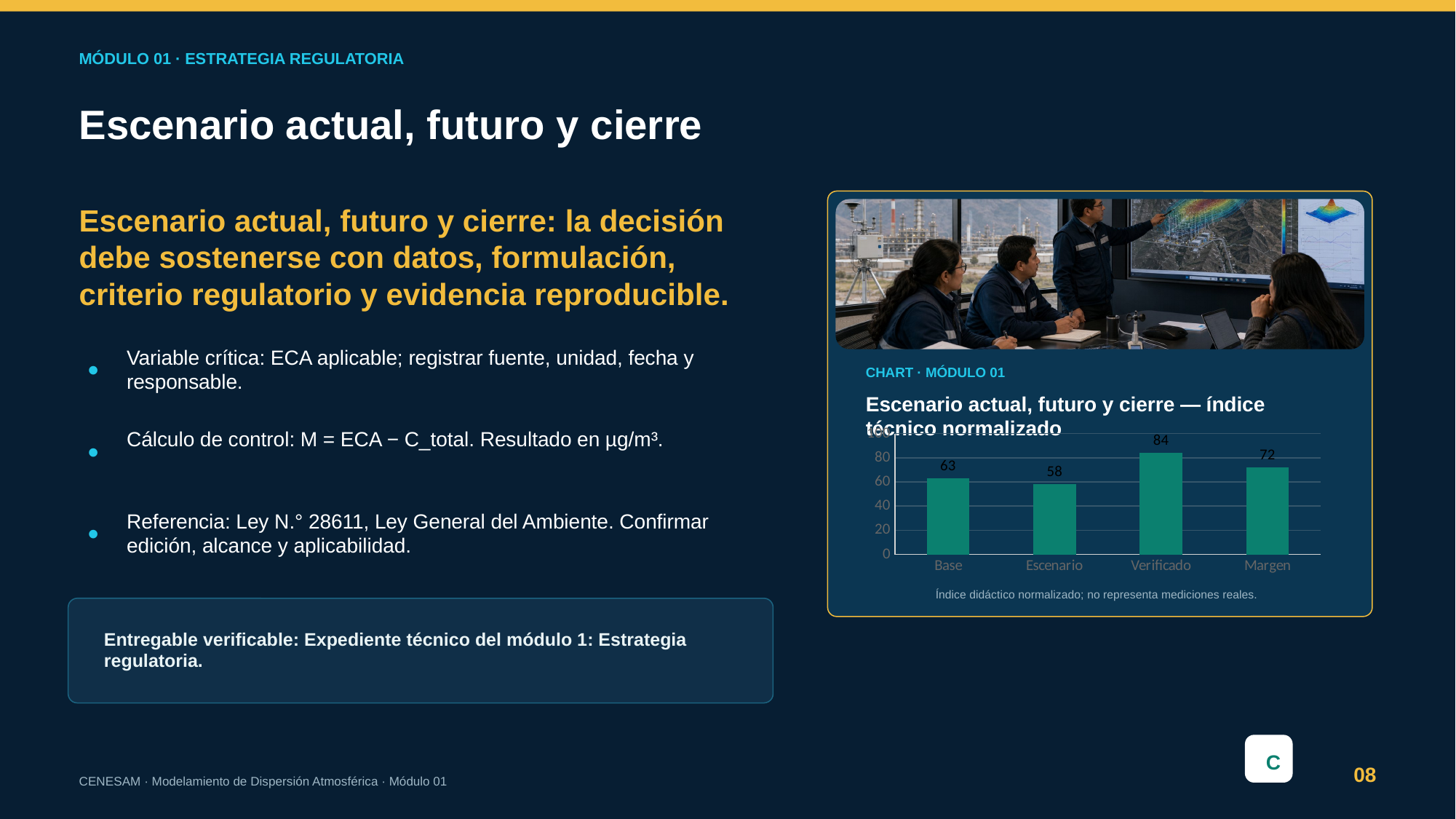
Which category has the highest value? Verificado What is the value for Verificado? 84 What is the value for Base? 63 Is the value for Verificado greater or less than 80? greater Which category has the lowest value? Escenario What is the value for Escenario? 58 What kind of chart is shown on the slide? Bar chart What is the title of the chart? Escenario actual, futuro y cierre — índice técnico normalizado Which is larger, the value for Margen or the value for Base? Margen What is the difference between the values for Verificado and Escenario? 26 How many categories are shown on the x axis? 4 What is the value for Margen? 72